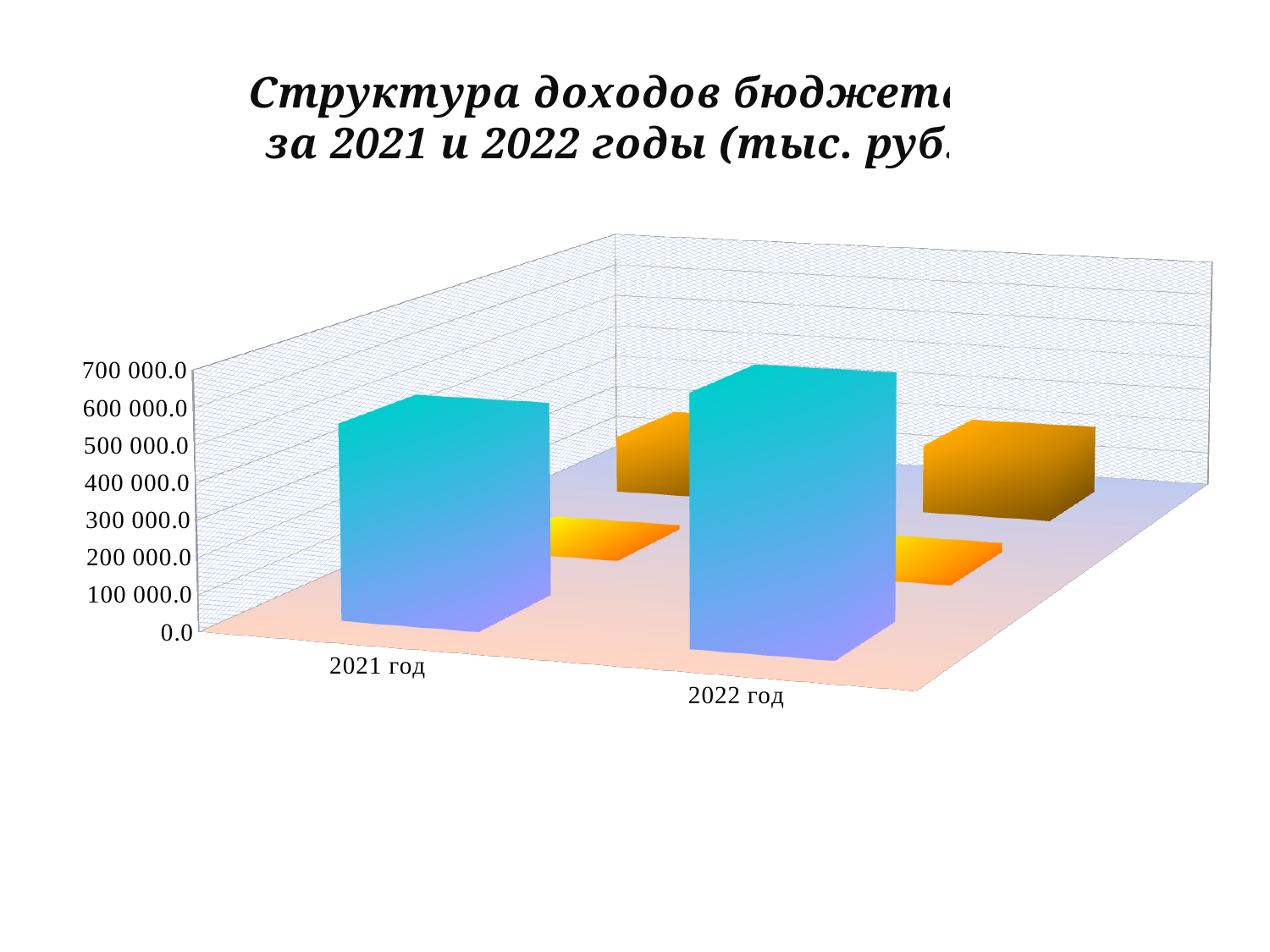
How many categories are shown on the x axis of the chart? 2 Does the blue series rise or fall from 2021 год to 2022 год? rise What kind of chart is shown on the slide? bar chart How many bars are plotted for each year category in the chart? 3 What are the two categories on the x axis of the chart? 2021 год, 2022 год Is the value of the blue bar for 2021 год greater or less than 300 000.0? greater What is the highest value shown on the vertical axis of the chart? 700 000.0 Is the value of the yellow bar for 2022 год greater or less than 400 000.0? less Which year has the taller blue bar, 2021 год or 2022 год? 2022 год Is the value of the yellow bar for 2021 год greater or less than 400 000.0? less